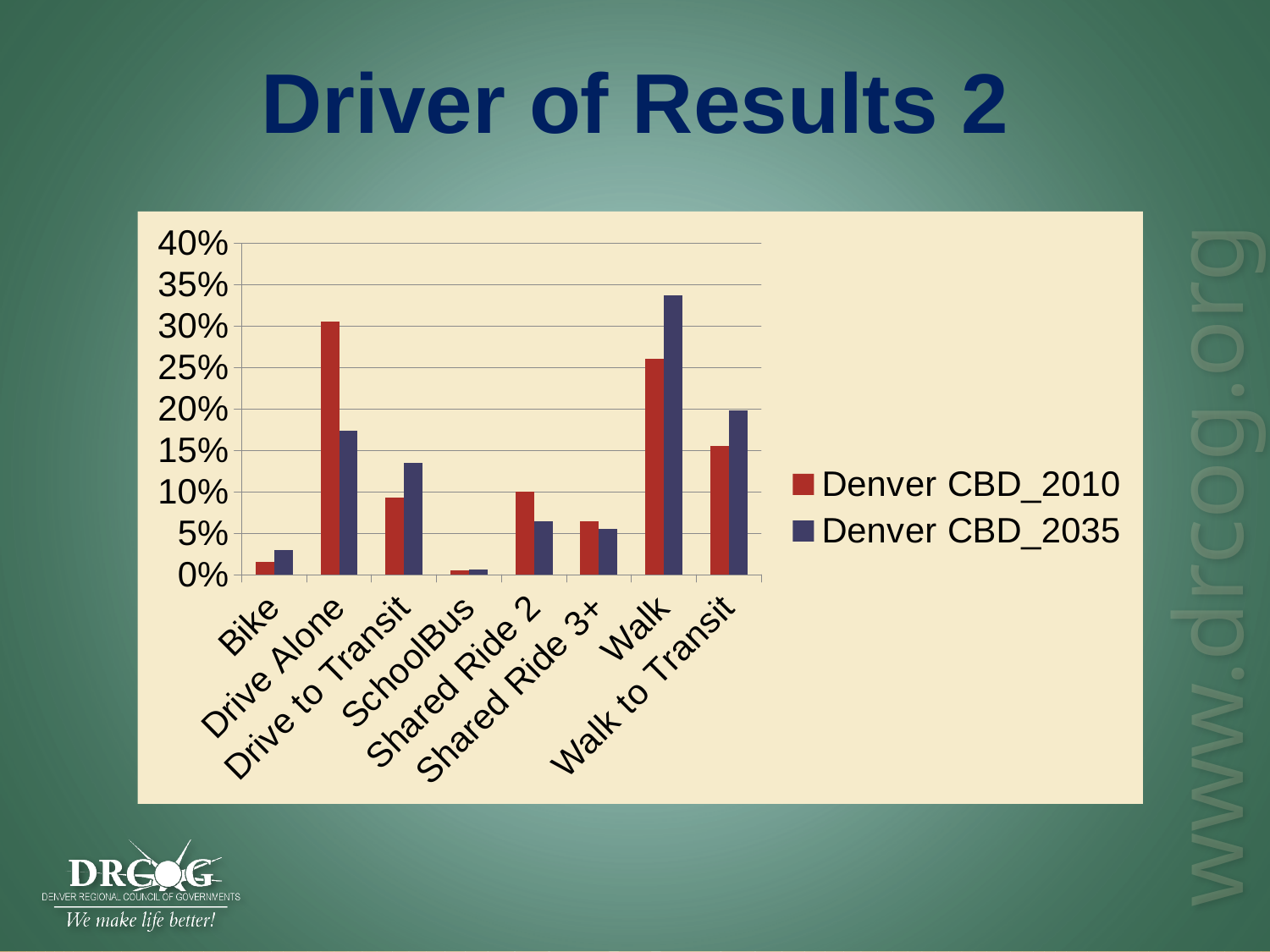
Is the Denver CBD_2035 value for Shared Ride 2 greater or less than 10%? less Which category has the lowest value for Denver CBD_2035? SchoolBus Which category has the highest value for Denver CBD_2010? Drive Alone Is the Denver CBD_2010 value for Drive Alone greater or less than 25%? greater How many series does the legend list? 2 For Walk, which series has the larger value, Denver CBD_2010 or Denver CBD_2035? Denver CBD_2035 What kind of chart is shown on the slide? bar chart What are the two series names listed in the legend? Denver CBD_2010 and Denver CBD_2035 For Drive Alone, which series has the larger value, Denver CBD_2010 or Denver CBD_2035? Denver CBD_2010 Which category has the highest value for Denver CBD_2035? Walk Is the Denver CBD_2035 value for Walk greater or less than 30%? greater How many categories are shown on the x axis? 8